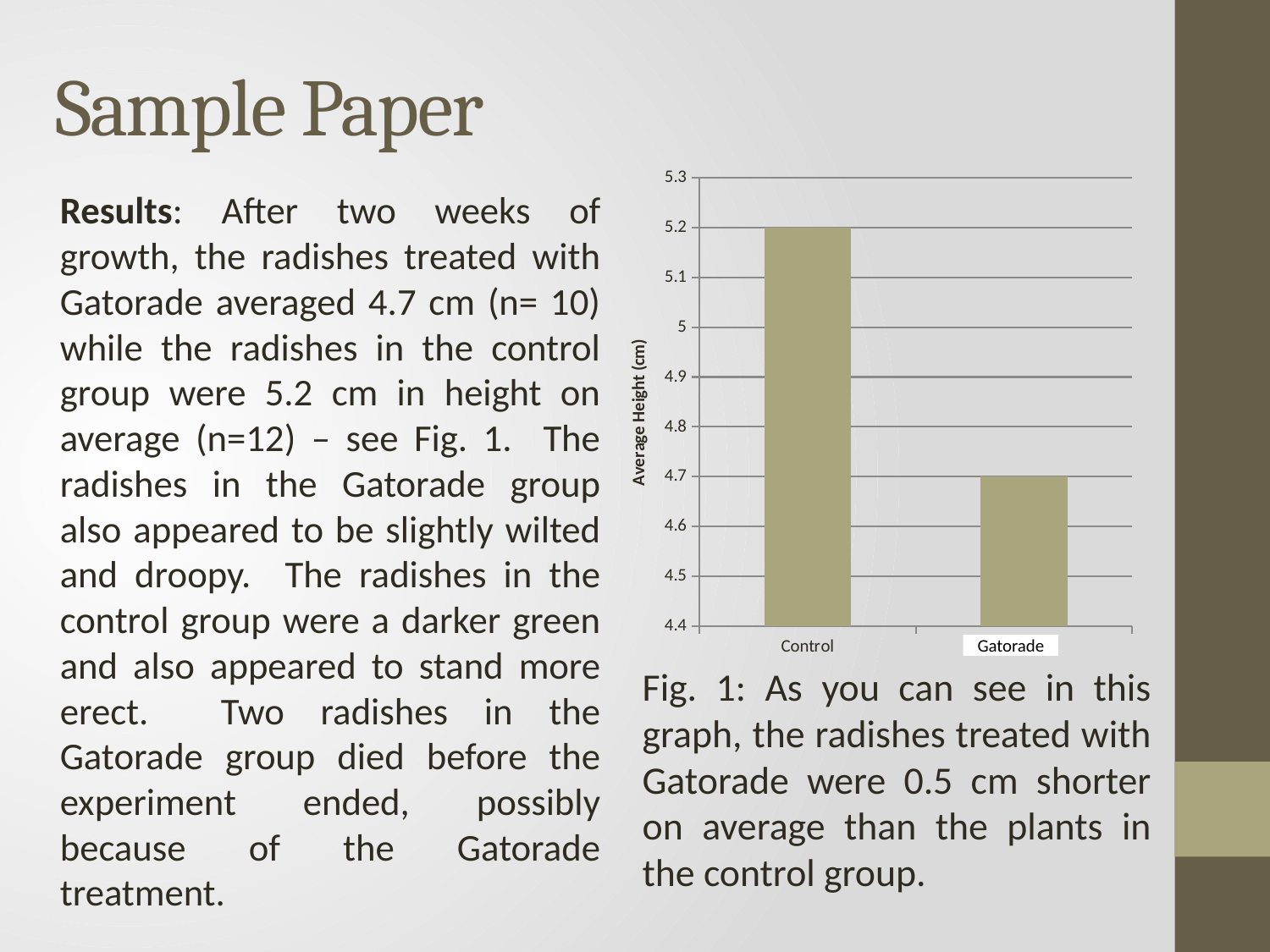
What kind of chart is shown on the slide? bar chart What is the average height for the Control group in the chart? 5.2 Is the value for Gatorade greater or less than 5? less What is the difference between the Control and Gatorade values in the chart? 0.5 Which is larger in the chart, the value for Control or the value for Gatorade? Control What is the label on the vertical axis of the chart? Average Height (cm) How many categories are plotted in the chart? 2 Which category has the highest bar in the chart? Control What is the lowest value shown on the vertical axis of the chart? 4.4 Which category has the lowest bar in the chart? Gatorade What is the average height for the Gatorade group in the chart? 4.7 Is the value for Control greater or less than 5? greater